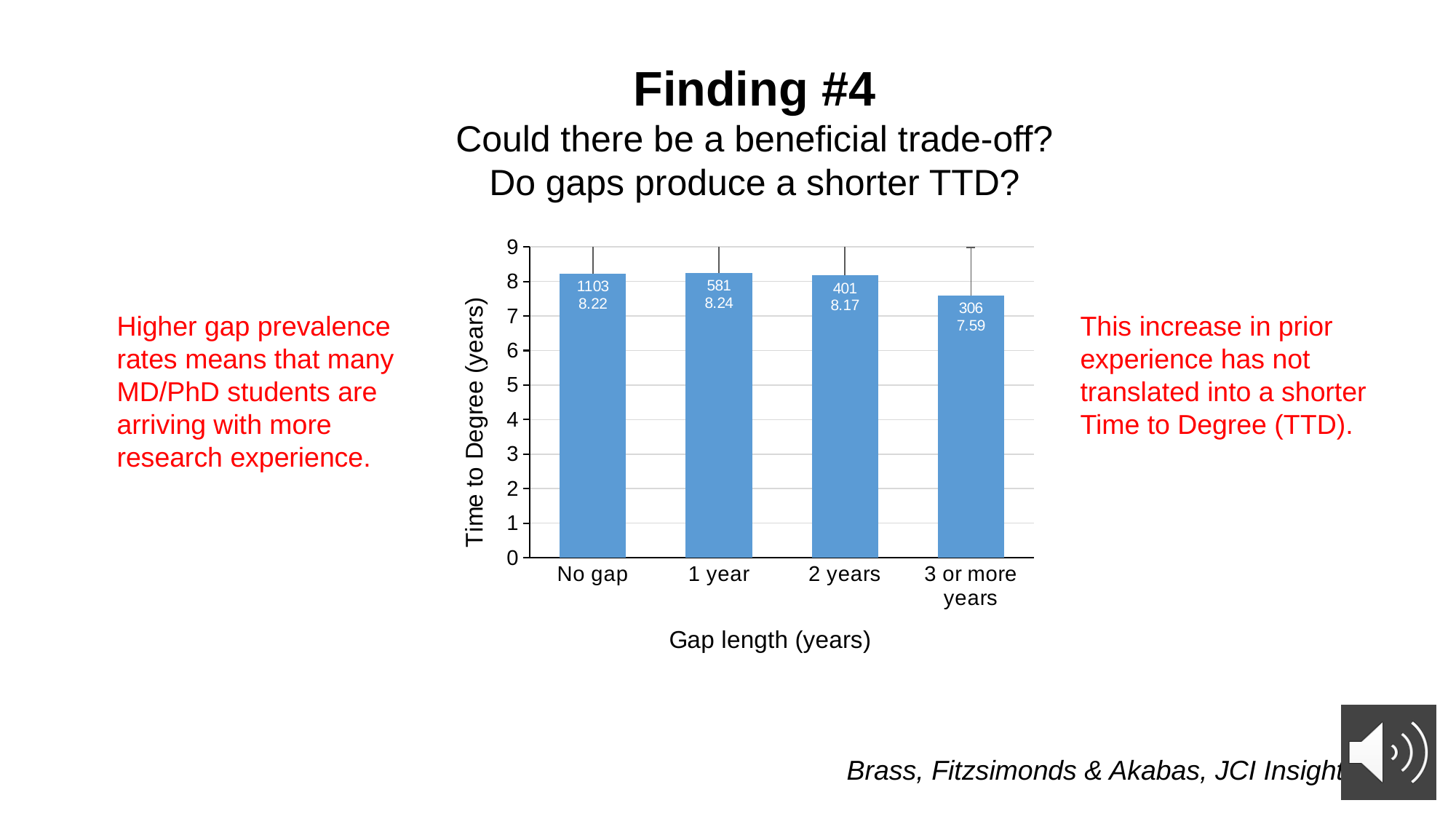
What is the label of the y axis of the chart? Time to Degree (years) What is the difference between the Time to Degree values for 1 year and 2 years? 0.07 Which has a larger Time to Degree value, 1 year or 3 or more years? 1 year Is the Time to Degree value for 3 or more years greater or less than 8? less How many gap length categories are shown on the x axis? 4 What is the Time to Degree value labeled on the bar for 3 or more years? 7.59 What is the upper number printed on the bar for 1 year? 581 What is the Time to Degree value labeled on the bar for 2 years? 8.17 What is the Time to Degree value labeled on the bar for No gap? 8.22 Which gap length category has the lowest Time to Degree? 3 or more years What kind of chart is shown on the slide? bar chart What is the difference between the Time to Degree values for No gap and 3 or more years? 0.63